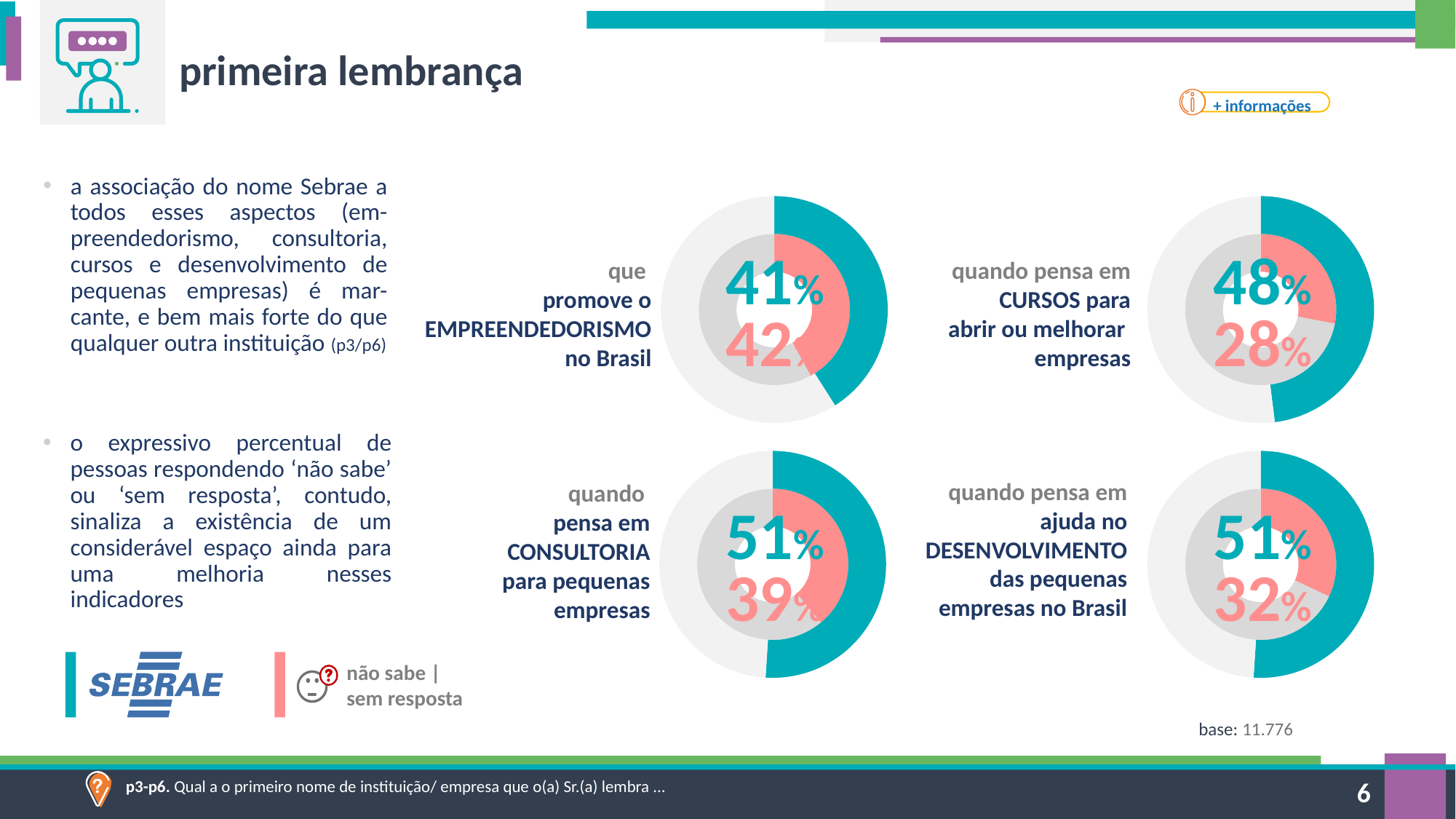
What type of chart is used to show the percentages on the slide? donut (pie) chart In the 'CONSULTORIA para pequenas empresas' chart, what percentage is shown for 'não sabe | sem resposta'? 39% Across the four donut charts, which topic has the lowest 'não sabe | sem resposta' percentage? CURSOS para abrir ou melhorar empresas In the 'CONSULTORIA para pequenas empresas' chart, which is larger: the teal Sebrae percentage or the 'não sabe | sem resposta' percentage? the teal Sebrae percentage (51%) In the 'promove o EMPREENDEDORISMO no Brasil' chart, what percentage is shown for 'não sabe | sem resposta'? 42% In the 'CURSOS para abrir ou melhorar empresas' chart, what percentage is shown for 'não sabe | sem resposta'? 28% In the 'CURSOS para abrir ou melhorar empresas' chart, what percentage is shown in teal for Sebrae? 48% How many donut charts are shown on the slide? 4 In the 'CURSOS para abrir ou melhorar empresas' chart, what is the difference between the teal Sebrae percentage and the 'não sabe | sem resposta' percentage? 20 percentage points Across the four donut charts, which topic has the lowest teal Sebrae percentage? promove o EMPREENDEDORISMO no Brasil In the 'ajuda no DESENVOLVIMENTO das pequenas empresas no Brasil' chart, what percentage is shown for 'não sabe | sem resposta'? 32% In the 'promove o EMPREENDEDORISMO no Brasil' chart, what percentage is shown in teal for Sebrae? 41%